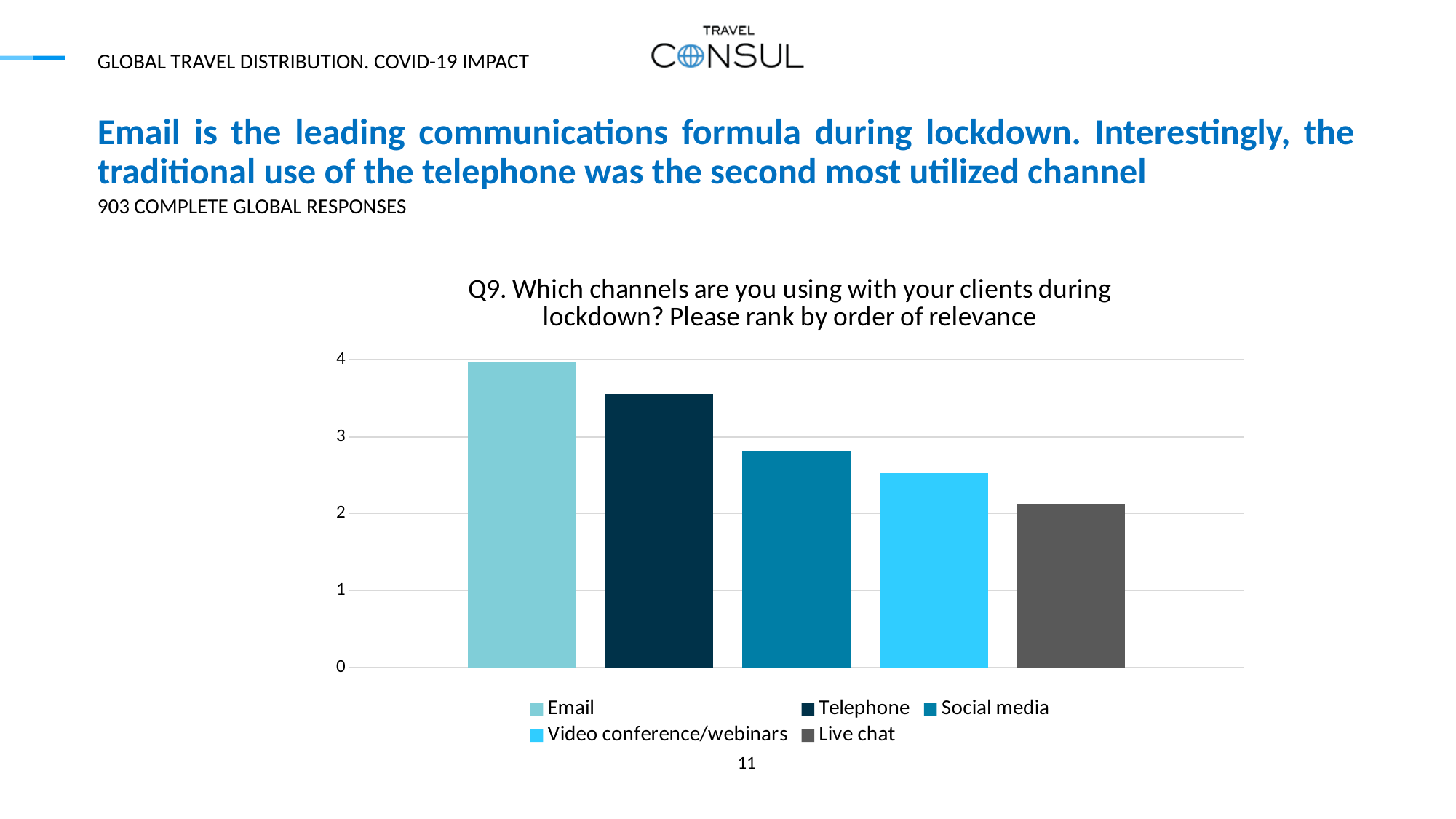
Is the value for Telephone greater or less than 3? greater Which channel has the highest value in the chart? Email What is the title of the chart? Q9. Which channels are you using with your clients during lockdown? Please rank by order of relevance Do the bar values rise or fall from left to right across the chart? fall How many entries does the chart legend list? 5 Is the value for Email greater or less than 3? greater How many bars are plotted in the chart? 5 Is the value for Social media greater or less than 3? less Which channel has the lowest value in the chart? Live chat What kind of chart is shown on the slide? bar chart Which is larger, the value for Telephone or the value for Social media? Telephone